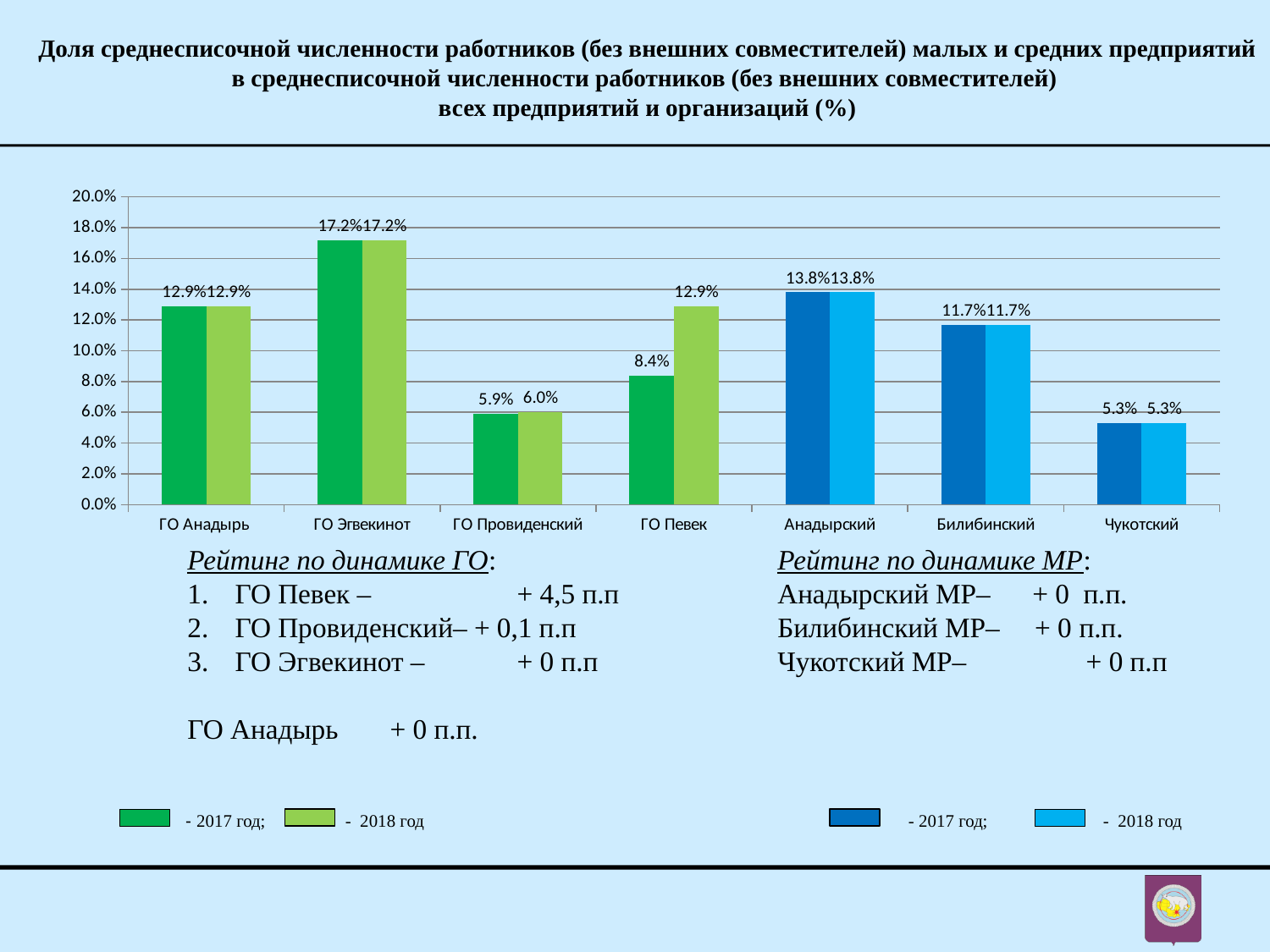
Which is larger: the 2017 value for Анадырский or the 2017 value for ГО Анадырь? Анадырский What is the 2017 value for ГО Певек? 8.4% What is the 2018 value for ГО Певек? 12.9% Which category has the lowest value in 2017? Чукотский What is the 2018 value for ГО Провиденский? 6.0% What is the difference between the 2018 and 2017 values for ГО Певек? 4.5 percentage points What type of chart is shown on the slide? bar chart Which category has the highest value in 2018? ГО Эгвекинот What is the 2017 value for Билибинский? 11.7% Is the 2018 value for ГО Эгвекинот greater or less than 16.0%? greater Which two years are compared in the chart according to the legend? 2017 год and 2018 год How many categories (territories) are shown on the x axis of the chart? 7